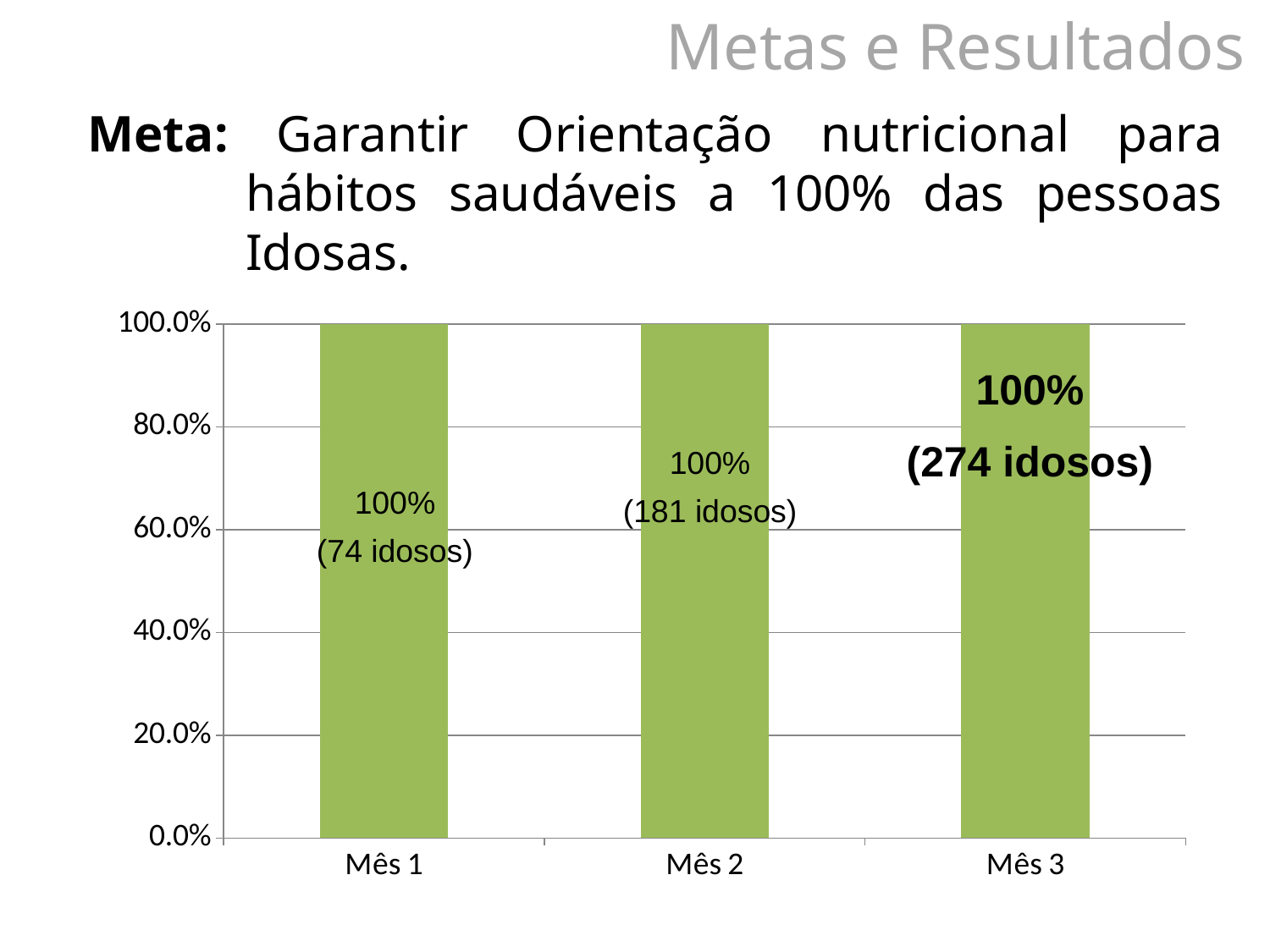
What percentage is shown for Mês 1? 100% Which month has the smallest number of idosos in its label? Mês 1 What kind of chart is shown on the slide? Bar chart What is the difference between the number of idosos for Mês 2 and Mês 1? 107 Which month has the largest number of idosos in its label? Mês 3 What colour are the bars in the chart? Green How many idosos are indicated in the label for Mês 3? 274 idosos Do the percentage values rise, fall or stay the same from Mês 1 to Mês 3? Stay the same What is the difference between the number of idosos for Mês 3 and Mês 1? 200 How many idosos are indicated in the label for Mês 2? 181 idosos How many idosos are indicated in the label for Mês 1? 74 idosos How many categories (months) are shown on the x axis? 3